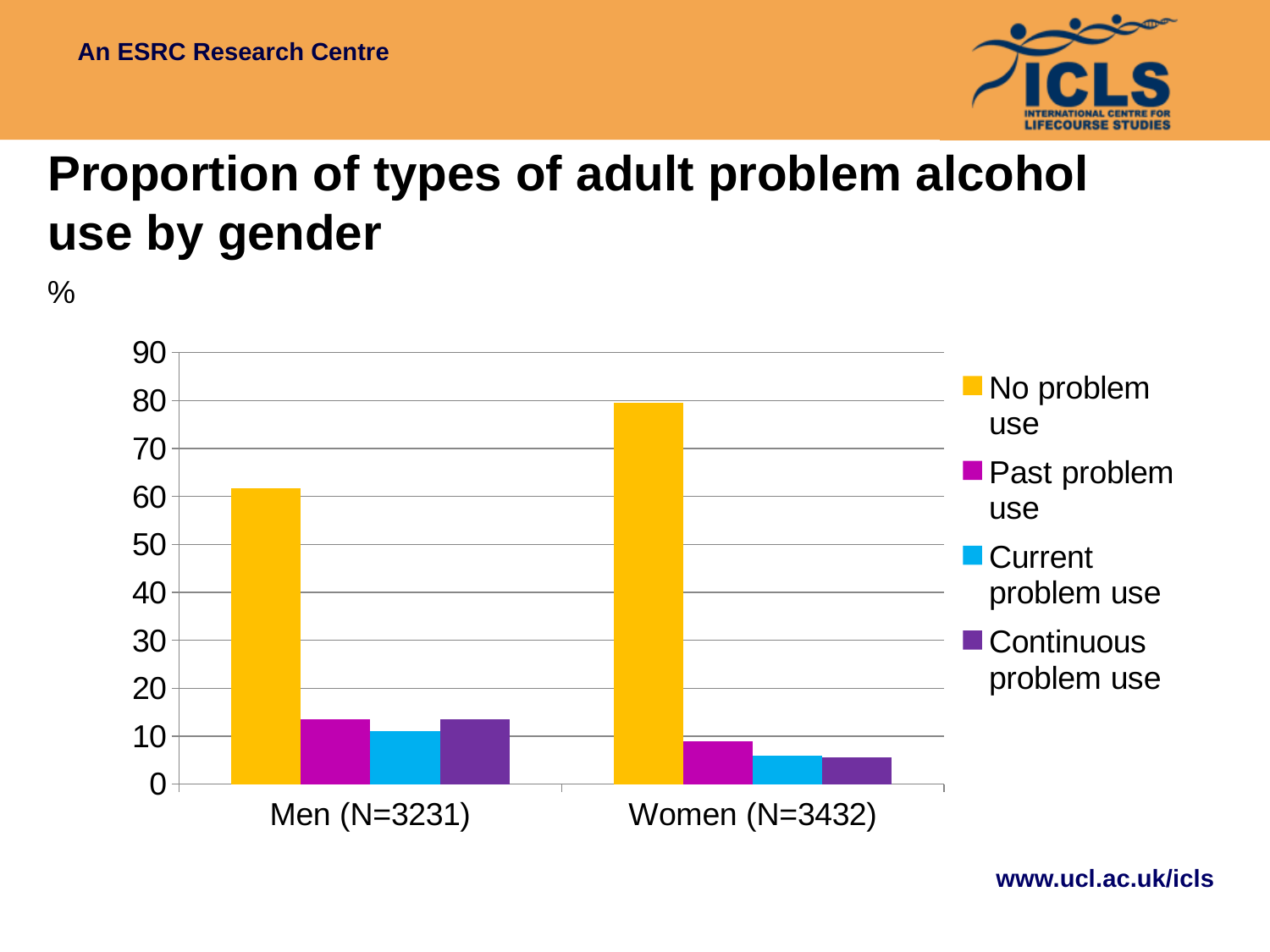
Which is larger for Men (N=3231): Past problem use or Current problem use? Past problem use Which is larger: No problem use for Men (N=3231) or No problem use for Women (N=3432)? Women (N=3432) What kind of chart is shown on the slide? bar chart Which series has the highest value for Men (N=3231)? No problem use Is the value for No problem use among Men (N=3231) greater or less than 70? less Is the value for Current problem use among Women (N=3432) greater or less than 10? less Is the value for No problem use among Women (N=3432) greater or less than 70? greater What is the title of the chart? Proportion of types of adult problem alcohol use by gender How many series does the legend list? 4 How many categories are shown on the x axis? 2